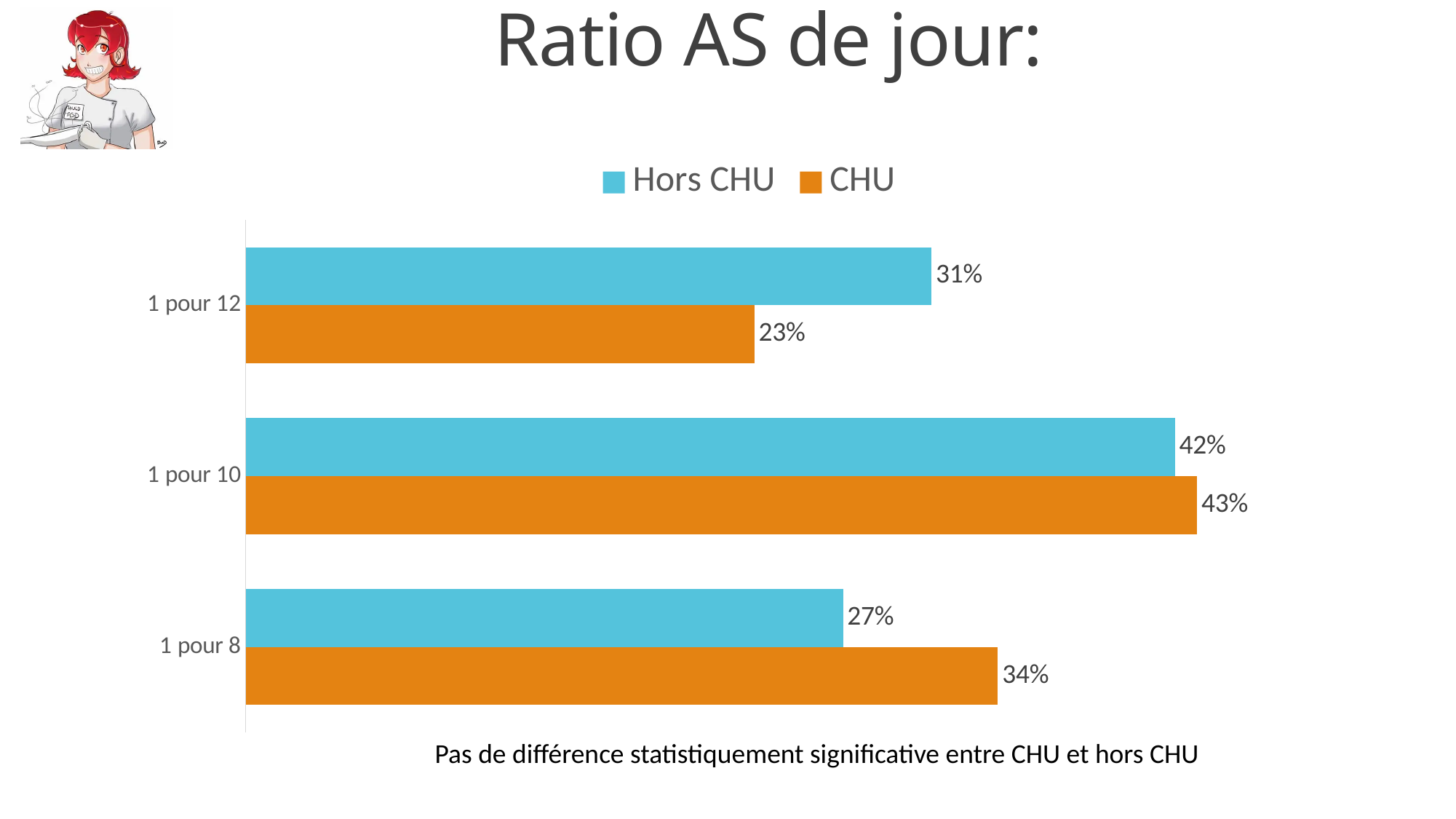
What is the Hors CHU value for '1 pour 12'? 31% What kind of chart is shown on the slide? Bar chart How many categories are shown on the chart? 3 What is the difference between the CHU and Hors CHU values for '1 pour 8'? 7% Which category has the highest Hors CHU value? 1 pour 10 What is the Hors CHU value for '1 pour 8'? 27% What is the difference between the Hors CHU and CHU values for '1 pour 12'? 8% How many series does the legend list? 2 What is the CHU value for '1 pour 8'? 34% What is the CHU value for '1 pour 10'? 43% For '1 pour 8', which series has the larger value, Hors CHU or CHU? CHU Which category has the lowest CHU value? 1 pour 12